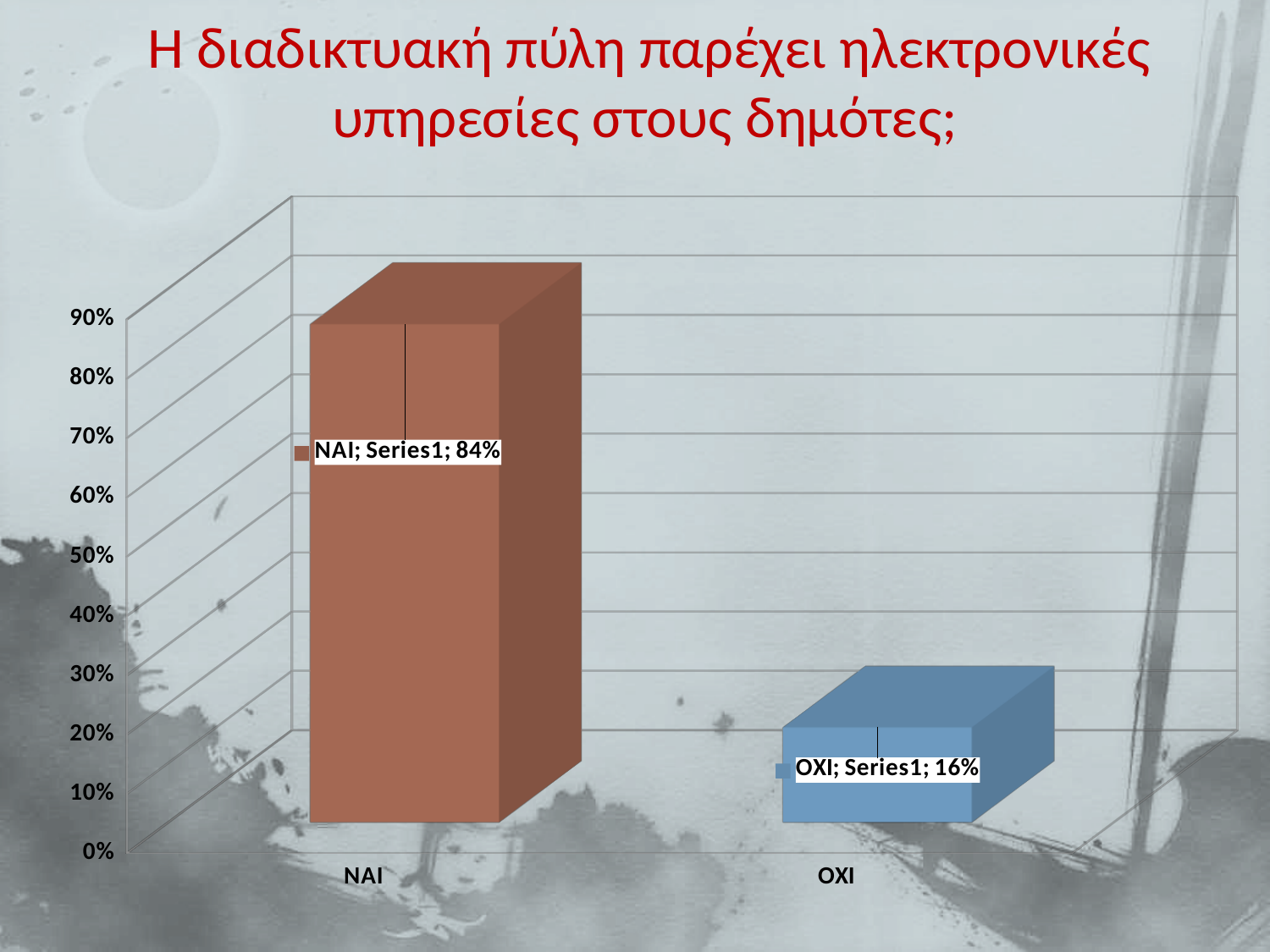
What is the title of the slide? Η διαδικτυακή πύλη παρέχει ηλεκτρονικές υπηρεσίες στους δημότες; What colour is the bar for ΟΧΙ? blue What is the difference between the values for ΝΑΙ and ΟΧΙ? 68% Is the value for ΝΑΙ greater or less than 50%? greater What is the value for ΟΧΙ? 16% What kind of chart is shown on the slide? bar chart Which is larger, the value for ΝΑΙ or the value for ΟΧΙ? ΝΑΙ What is the value for ΝΑΙ? 84% Which category has the lowest value? ΟΧΙ Is the value for ΟΧΙ greater or less than 20%? less How many categories are shown on the x axis? 2 Which category has the highest value? ΝΑΙ